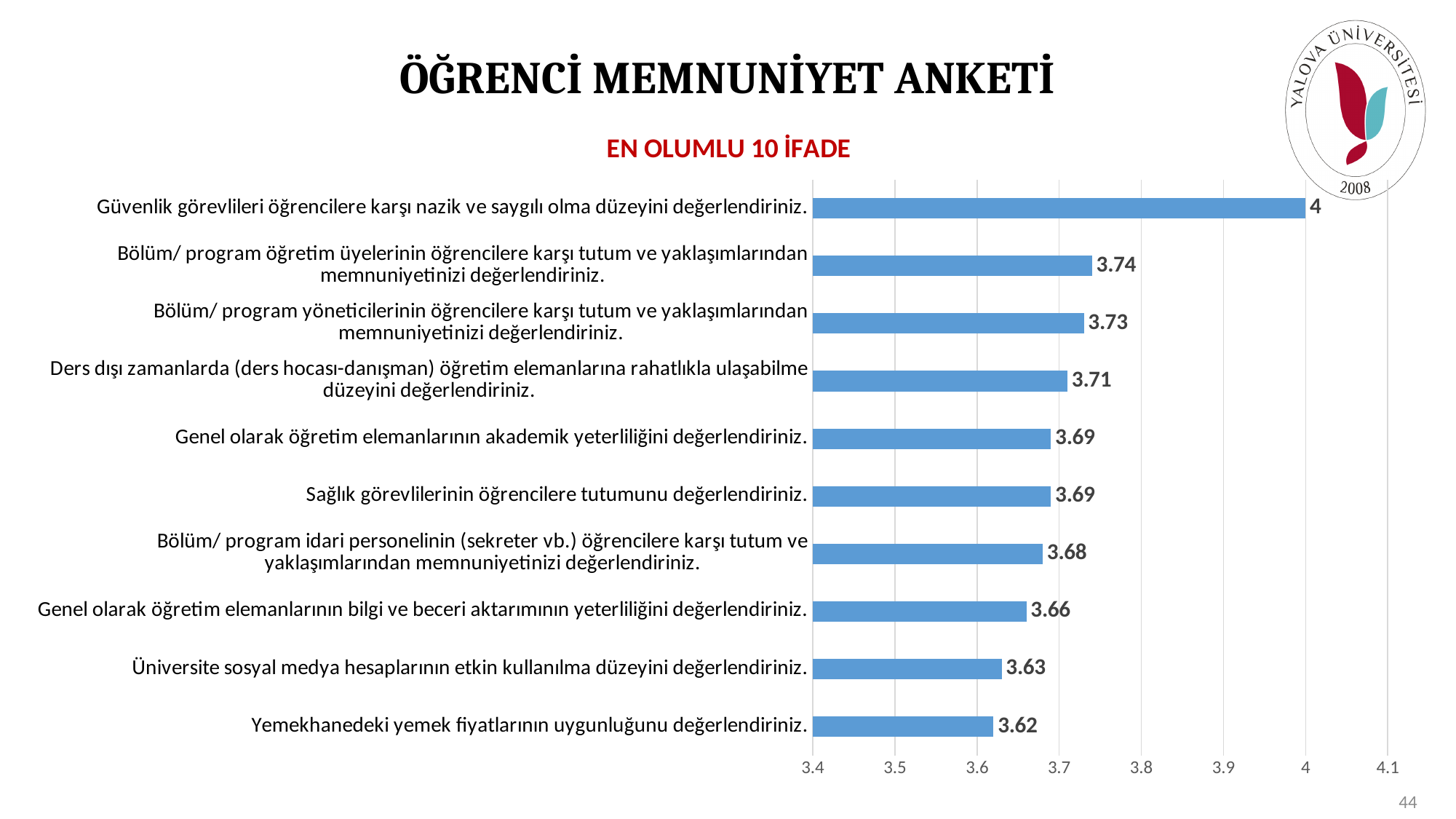
What is the value for "Üniversite sosyal medya hesaplarının etkin kullanılma düzeyini değerlendiriniz."? 3.63 What is the difference between the value for "Güvenlik görevlileri öğrencilere karşı nazik ve saygılı olma düzeyini değerlendiriniz." and the value for "Yemekhanedeki yemek fiyatlarının uygunluğunu değerlendiriniz."? 0.38 Which statement has the highest value? Güvenlik görevlileri öğrencilere karşı nazik ve saygılı olma düzeyini değerlendiriniz. Which statement has the lowest value? Yemekhanedeki yemek fiyatlarının uygunluğunu değerlendiriniz. What is the value for "Yemekhanedeki yemek fiyatlarının uygunluğunu değerlendiriniz."? 3.62 How many statements are shown in the chart? 10 What kind of chart is shown on the slide? bar chart What is the value for "Güvenlik görevlileri öğrencilere karşı nazik ve saygılı olma düzeyini değerlendiriniz."? 4 What is the subtitle shown above the chart? EN OLUMLU 10 İFADE What is the value for "Sağlık görevlilerinin öğrencilere tutumunu değerlendiriniz."? 3.69 Is the value for "Ders dışı zamanlarda (ders hocası-danışman) öğretim elemanlarına rahatlıkla ulaşabilme düzeyini değerlendiriniz." greater or less than 3.7? greater Which is larger: the value for "Bölüm/ program öğretim üyelerinin öğrencilere karşı tutum ve yaklaşımlarından memnuniyetinizi değerlendiriniz." or the value for "Genel olarak öğretim elemanlarının bilgi ve beceri aktarımının yeterliliğini değerlendiriniz."? Bölüm/ program öğretim üyelerinin öğrencilere karşı tutum ve yaklaşımlarından memnuniyetinizi değerlendiriniz.